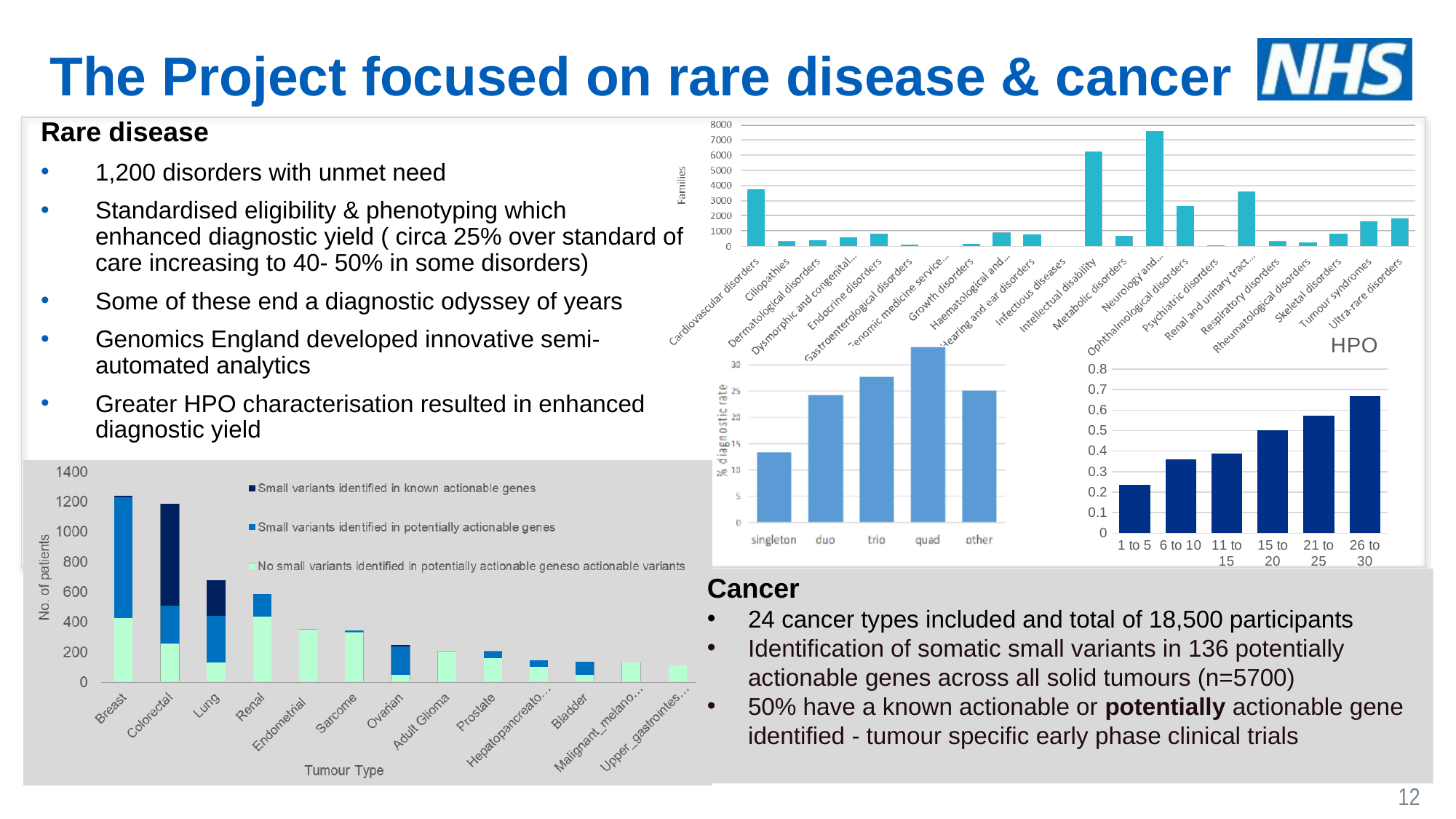
How many series does the legend list in the bottom-left Tumour Type chart? 3 In the % diagnostic rate chart, which family structure has the highest diagnostic rate? quad How many categories are shown in the % diagnostic rate chart? 5 In the HPO chart, do the values rise or fall from left to right along the x axis? rise In the % diagnostic rate chart, which family structure has the lowest diagnostic rate? singleton In the bottom-left Tumour Type chart, which tumour type has the highest total number of patients? Breast What kind of chart is the bottom-left Tumour Type chart? stacked bar chart In the Families chart at the top right, which is larger, Intellectual disability or Neurology and...? Neurology and... In the HPO chart, is the value for 26 to 30 greater or less than 0.6? greater In the Families chart at the top right, which category has the highest number of families? Neurology and... In the Families chart at the top right, is the value for Cardiovascular disorders greater or less than 3000? greater In the Families chart at the top right, is the value for Intellectual disability greater or less than 6000? greater